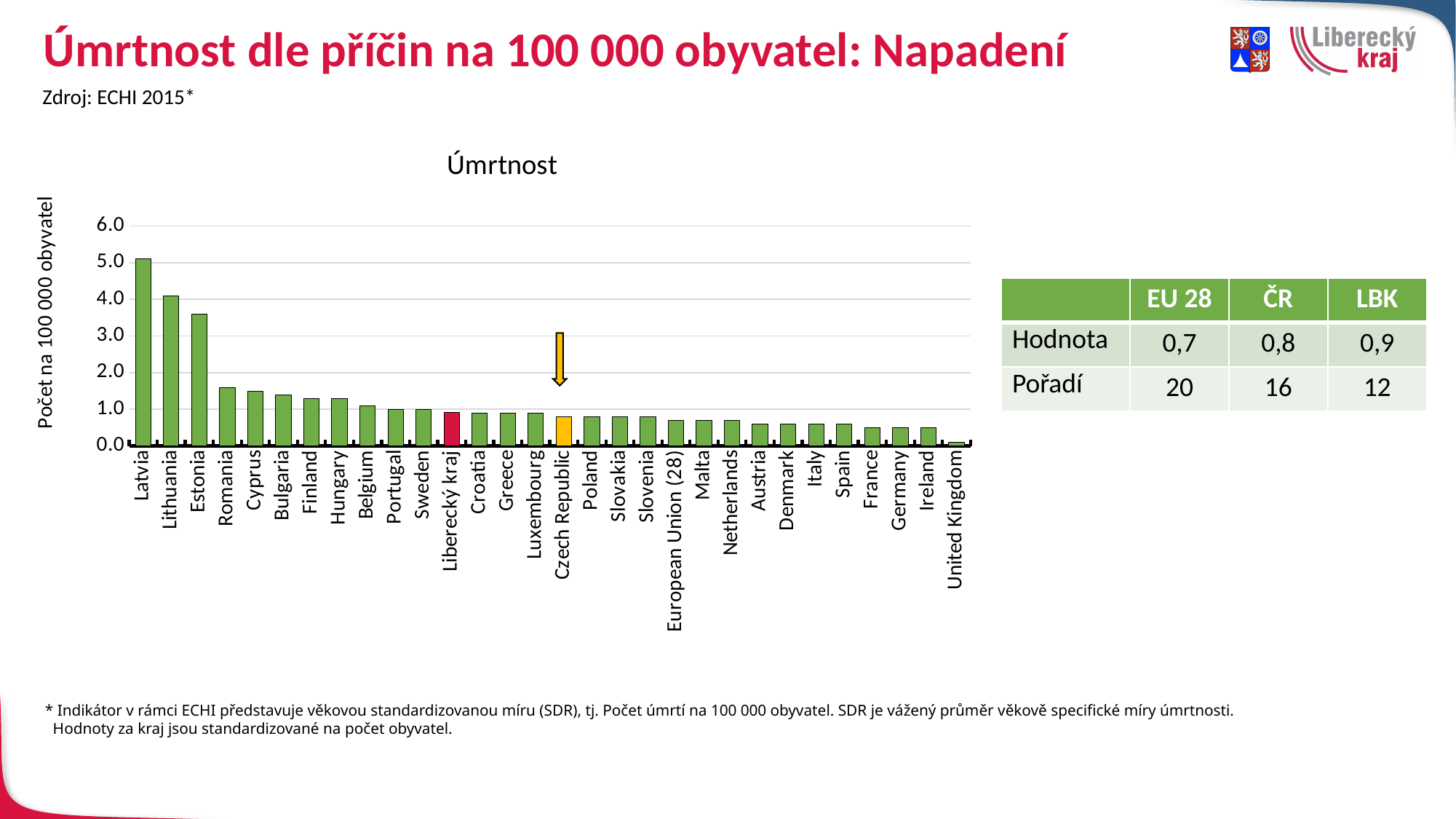
How many bars (categories) are plotted in the chart? 30 What kind of chart is shown on the slide? bar chart What is the title of the chart? Úmrtnost Is the value for Latvia greater or less than 4.0? greater What colour is the bar for Liberecký kraj? red Is the value for Romania greater or less than 2.0? less Which has the larger value, Estonia or Romania? Estonia Is the value for Estonia greater or less than 3.0? greater Which country has the lowest value in the chart? United Kingdom Which country has the highest value in the chart? Latvia Do the values rise or fall from left to right along the x axis? fall